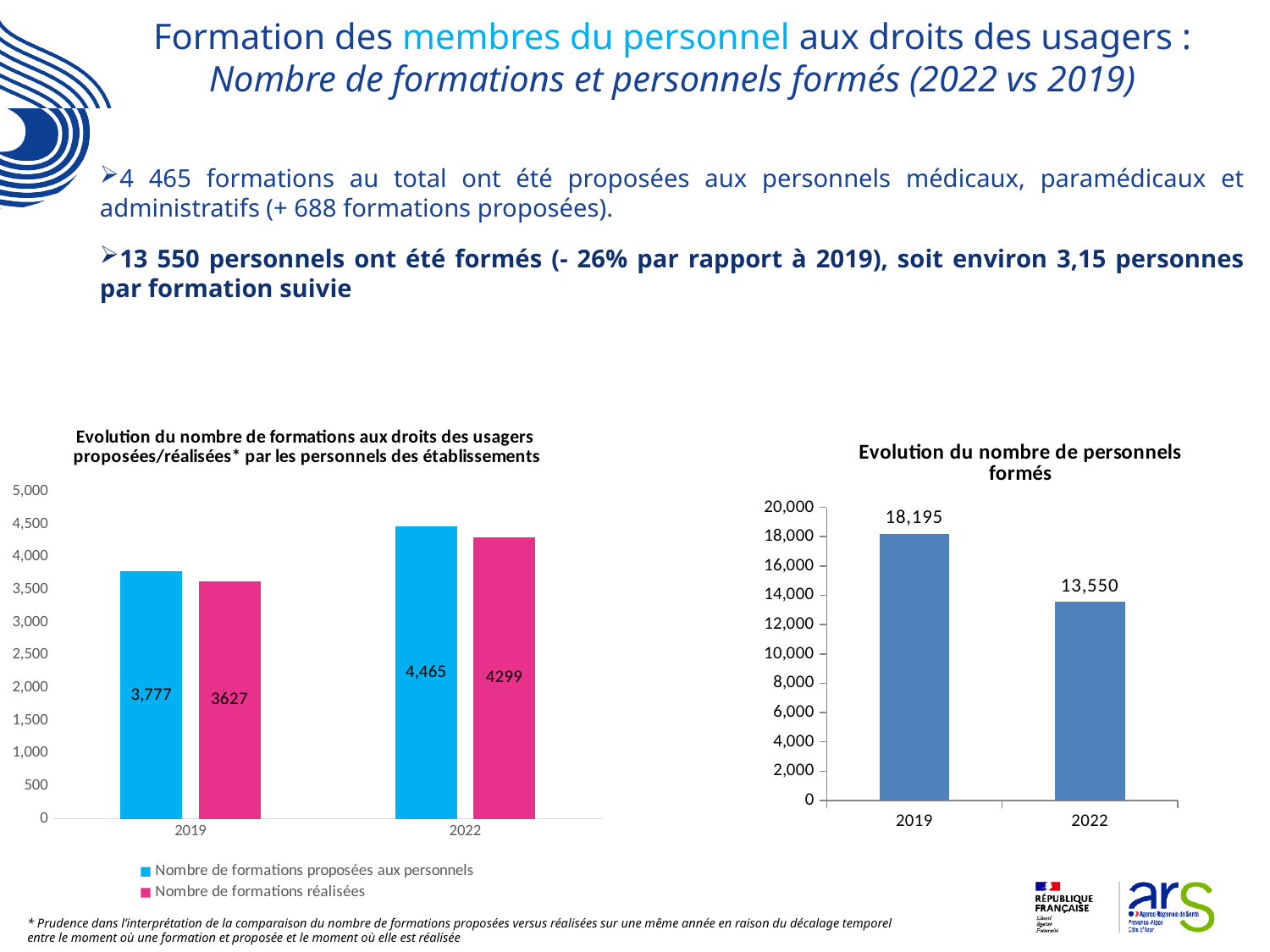
In the left chart (Evolution du nombre de formations aux droits des usagers proposées/réalisées), how many series does the legend list? 2 In the right chart (Evolution du nombre de personnels formés), what is the difference between the 2019 and 2022 values? 4,645 In the right chart (Evolution du nombre de personnels formés), do the values rise or fall from 2019 to 2022? Fall What kind of chart is the right chart (Evolution du nombre de personnels formés)? Bar chart In the left chart (Evolution du nombre de formations aux droits des usagers proposées/réalisées), which year has the higher value for 'Nombre de formations proposées aux personnels'? 2022 In the left chart (Evolution du nombre de formations aux droits des usagers proposées/réalisées), what is the value for 'Nombre de formations réalisées' in 2019? 3627 In the left chart (Evolution du nombre de formations aux droits des usagers proposées/réalisées), what colour are the bars for 'Nombre de formations réalisées'? Pink In the right chart (Evolution du nombre de personnels formés), what is the value for 2022? 13,550 In the right chart (Evolution du nombre de personnels formés), what is the value for 2019? 18,195 In the left chart (Evolution du nombre de formations aux droits des usagers proposées/réalisées), what is the difference between formations proposées and formations réalisées in 2022? 166 In the left chart (Evolution du nombre de formations aux droits des usagers proposées/réalisées), what is the value for 'Nombre de formations réalisées' in 2022? 4299 In the left chart (Evolution du nombre de formations aux droits des usagers proposées/réalisées), what is the value for 'Nombre de formations proposées aux personnels' in 2019? 3,777